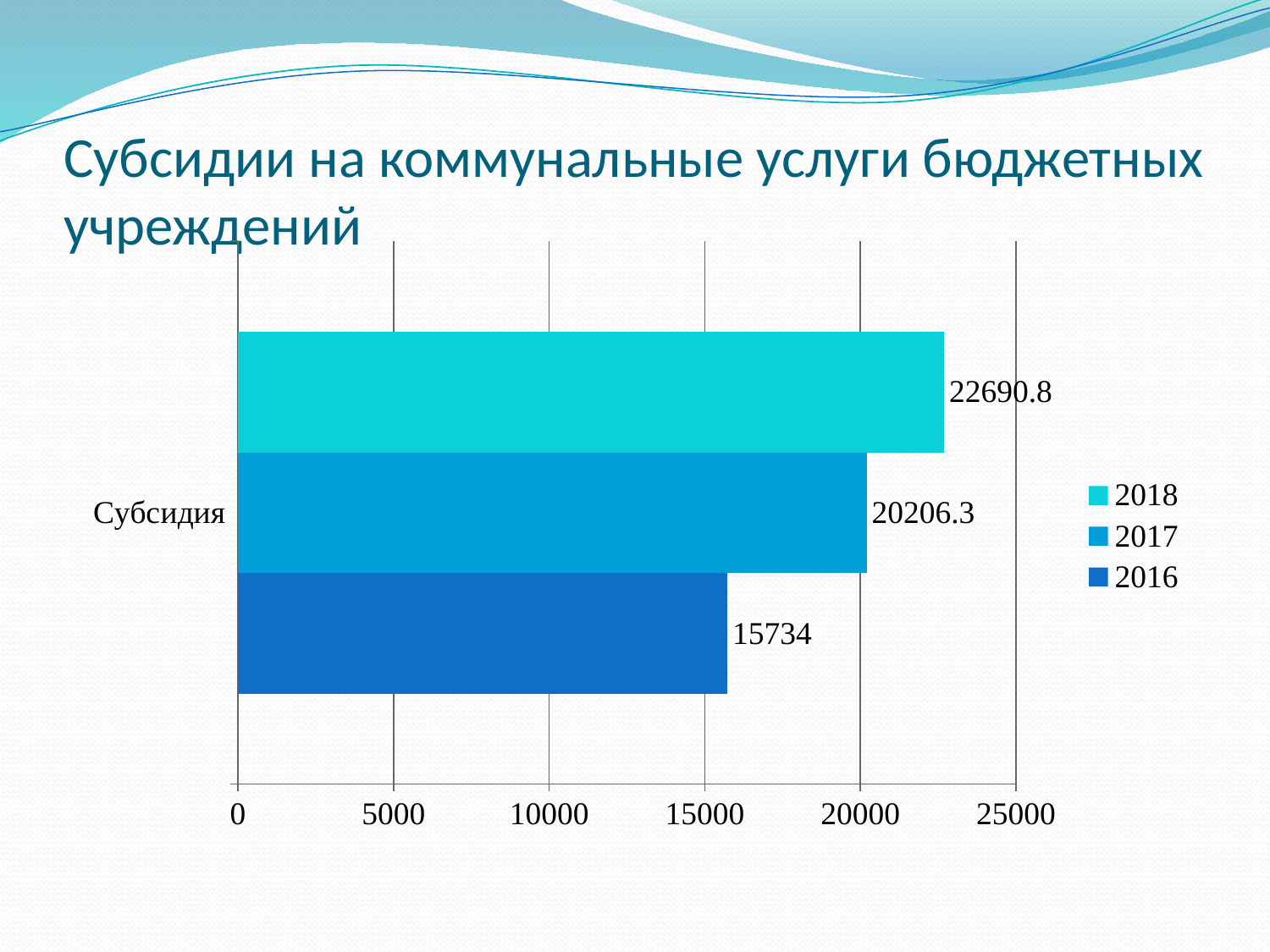
What kind of chart is shown on the slide? bar chart What is the value for 2018 in the chart? 22690.8 Which year has the lowest subsidy value? 2016 How many series does the legend list? 3 What is the difference between the 2017 and 2016 values? 4472.3 What is the value for 2017 in the chart? 20206.3 Which is larger, the value for 2017 or the value for 2016? 2017 What is the category label shown on the vertical axis of the chart? Субсидия Is the value for 2016 greater or less than 20000? less What is the value for 2016 in the chart? 15734 What is the difference between the 2018 and 2017 values? 2484.5 Which year has the highest subsidy value? 2018